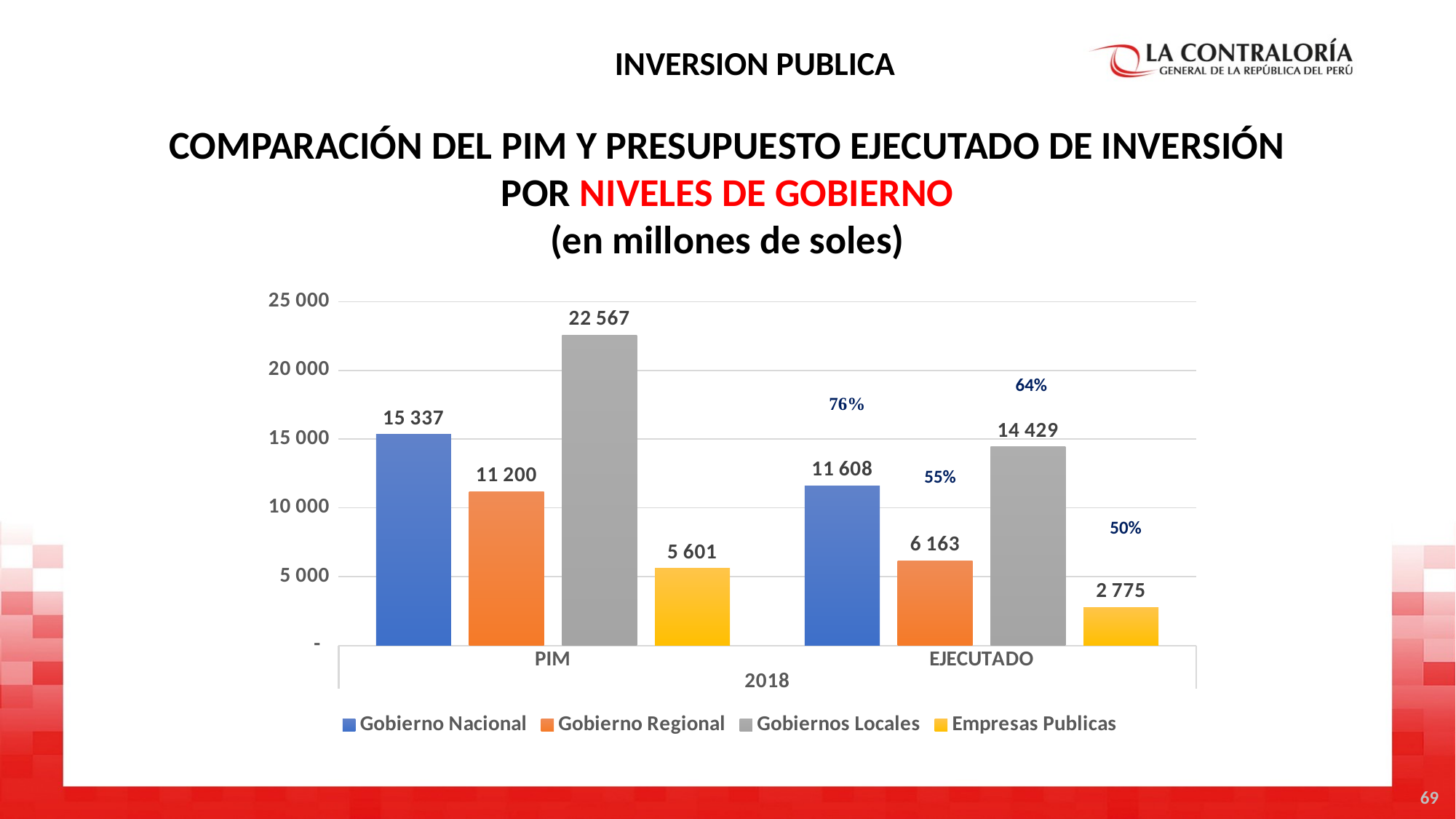
How many series does the legend list? 4 Which is larger: the PIM value for Gobierno Regional or the EJECUTADO value for Gobiernos Locales? EJECUTADO value for Gobiernos Locales What is the EJECUTADO value for Gobierno Regional? 6 163 What is the EJECUTADO value for Empresas Publicas? 2 775 Which series has the lowest EJECUTADO value? Empresas Publicas What is the difference between the PIM and EJECUTADO values for Gobierno Nacional? 3 729 What percentage is shown above the EJECUTADO bar for Gobierno Nacional? 76% What percentage is shown above the EJECUTADO bar for Empresas Publicas? 50% Which series has the highest PIM value? Gobiernos Locales What is the PIM value for Gobiernos Locales? 22 567 What colour are the Gobiernos Locales bars? Grey What kind of chart is shown on the slide? Bar chart